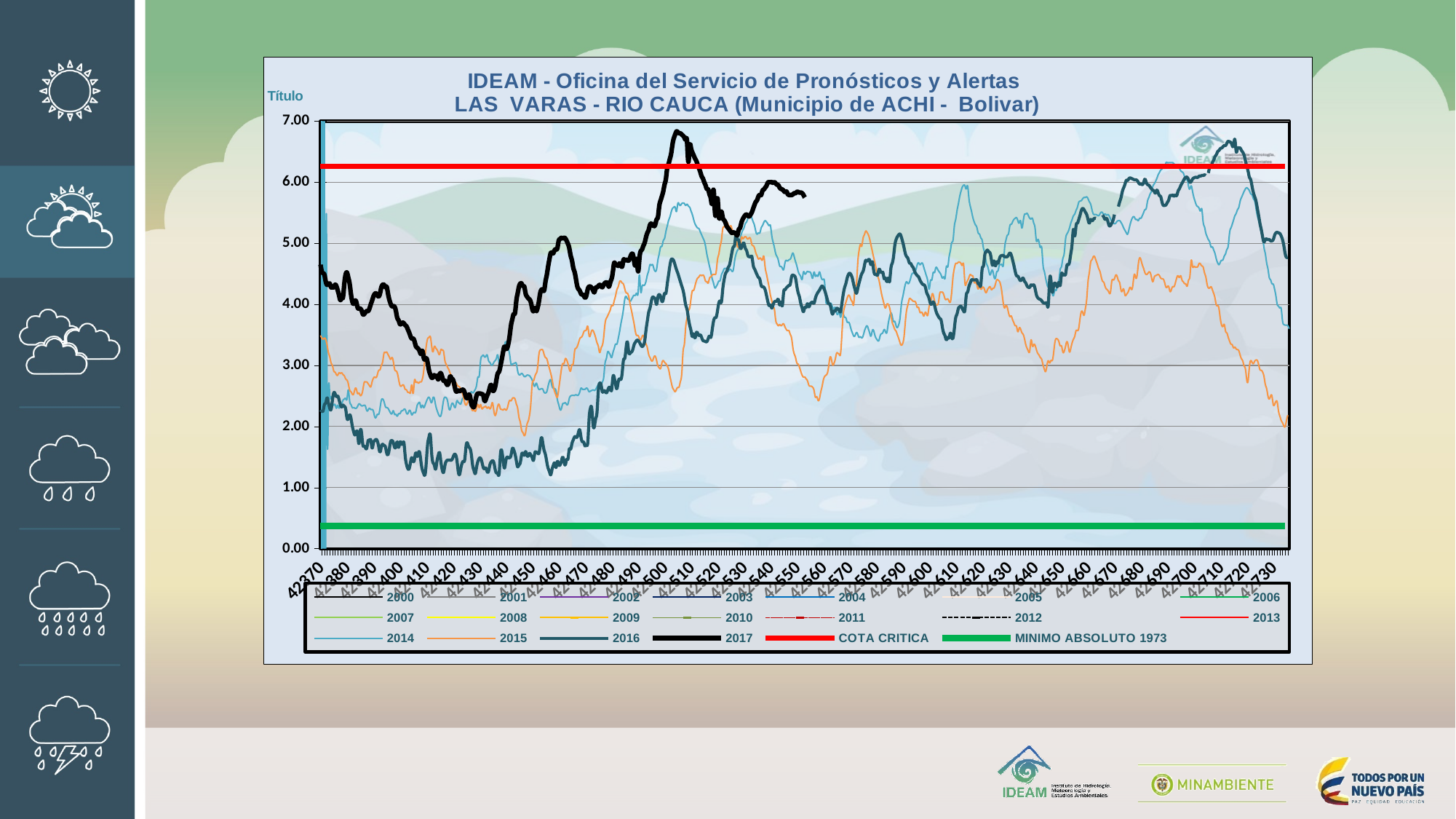
What is the first value labelled on the horizontal axis? 42370 Is the peak value of the 2017 series greater or less than 6.00? greater Is the lowest value of the 2016 series greater or less than 2.00? less What is the title of the chart? IDEAM - Oficina del Servicio de Pronósticos y Alertas LAS VARAS - RIO CAUCA (Municipio de ACHI - Bolivar) How many entries does the chart legend list? 20 What is the highest value shown on the vertical axis? 7.00 What kind of chart is shown on the slide? line chart Does the 2017 series peak above or below the COTA CRITICA line? above Is the MINIMO ABSOLUTO 1973 line greater or less than 1.00? less Which is higher on the chart, the COTA CRITICA line or the MINIMO ABSOLUTO 1973 line? COTA CRITICA